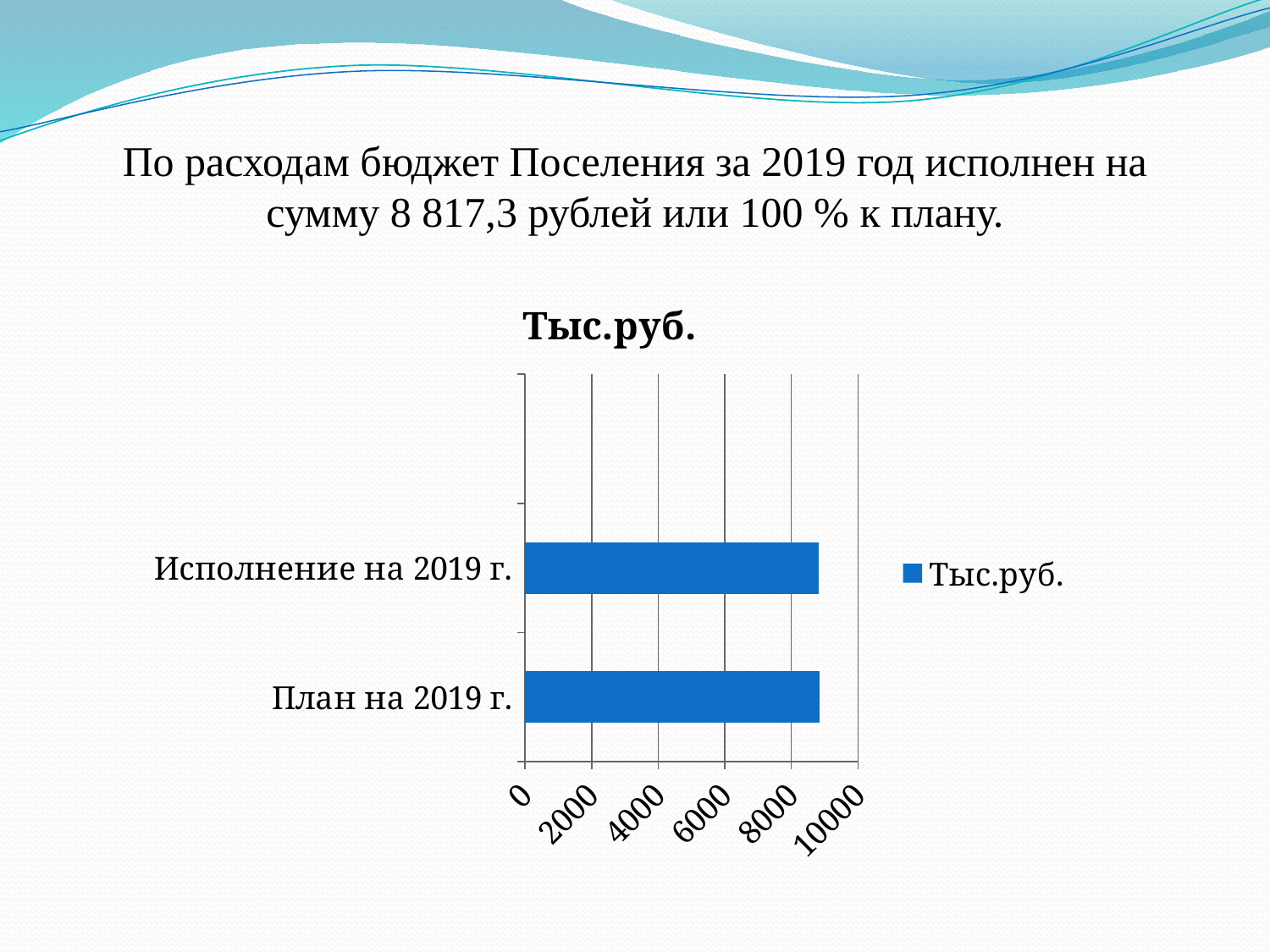
Is the value for План на 2019 г. greater or less than 10000? less How many series does the chart legend list? 1 How many categories are plotted in the chart? 2 What kind of chart is shown on the slide? bar chart Is the value for План на 2019 г. greater or less than 8000? greater Is the value for Исполнение на 2019 г. greater or less than 6000? greater What series name appears in the chart legend? Тыс.руб. What is the title of the chart? Тыс.руб.